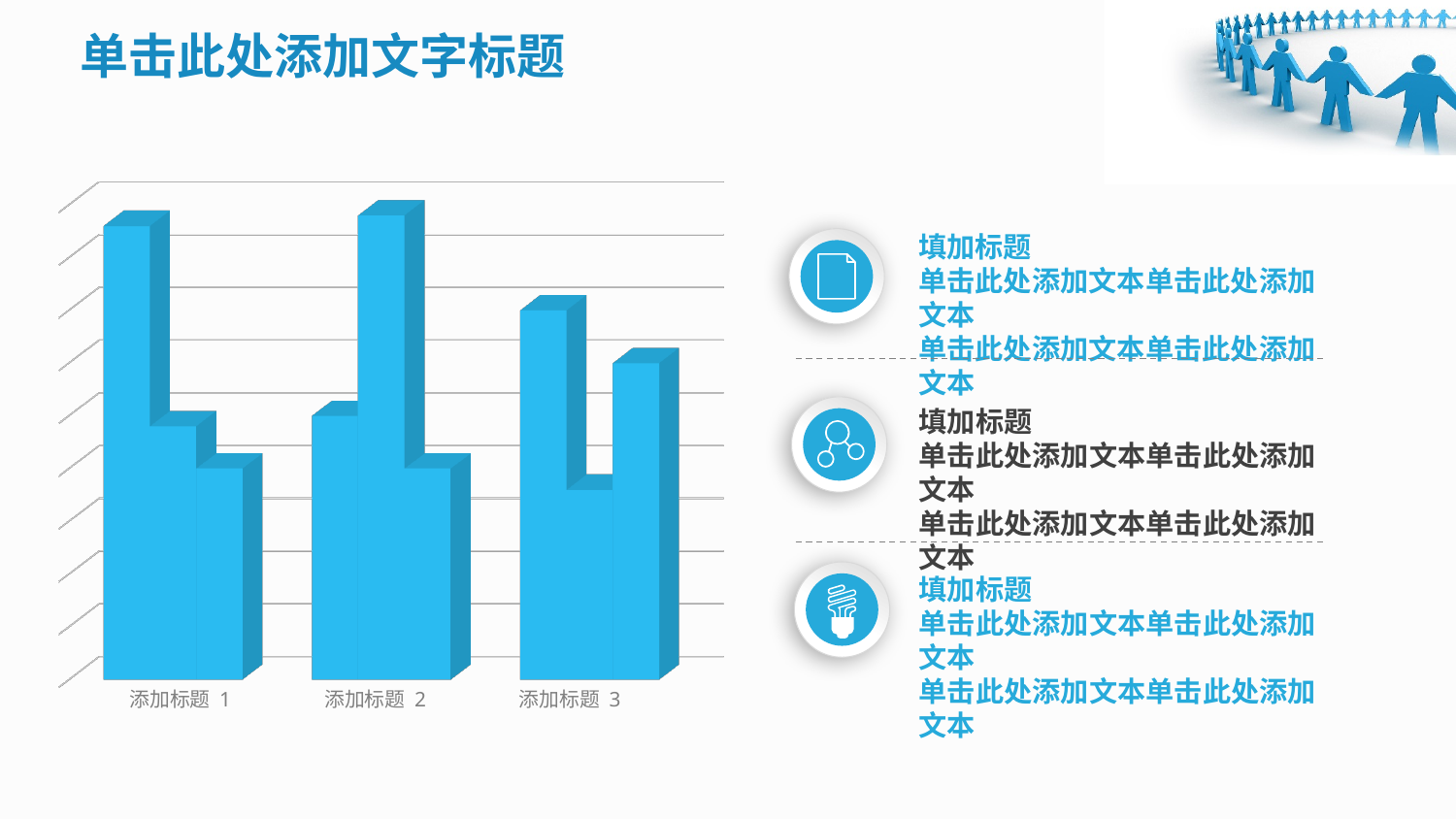
Which is taller: the first bar of 添加标题 1 or the first bar of 添加标题 3? the first bar of 添加标题 1 How many bars are plotted in total in the chart? 9 Which category contains the tallest bar in the chart? 添加标题 2 How many bars are plotted for each category in the chart? 3 What kind of chart is shown on the slide? bar chart Within the category 添加标题 1, which bar is taller: the first (leftmost) bar or the second bar? the first bar What is the label of the last category on the x axis? 添加标题 3 Which is taller: the third bar of 添加标题 3 or the third bar of 添加标题 1? the third bar of 添加标题 3 How many categories are shown on the x axis of the chart? 3 What is the label of the first category on the x axis? 添加标题 1 Within the category 添加标题 3, which bar is the shortest? the second (middle) bar Within the category 添加标题 2, do the bars rise or fall from left to right? fall